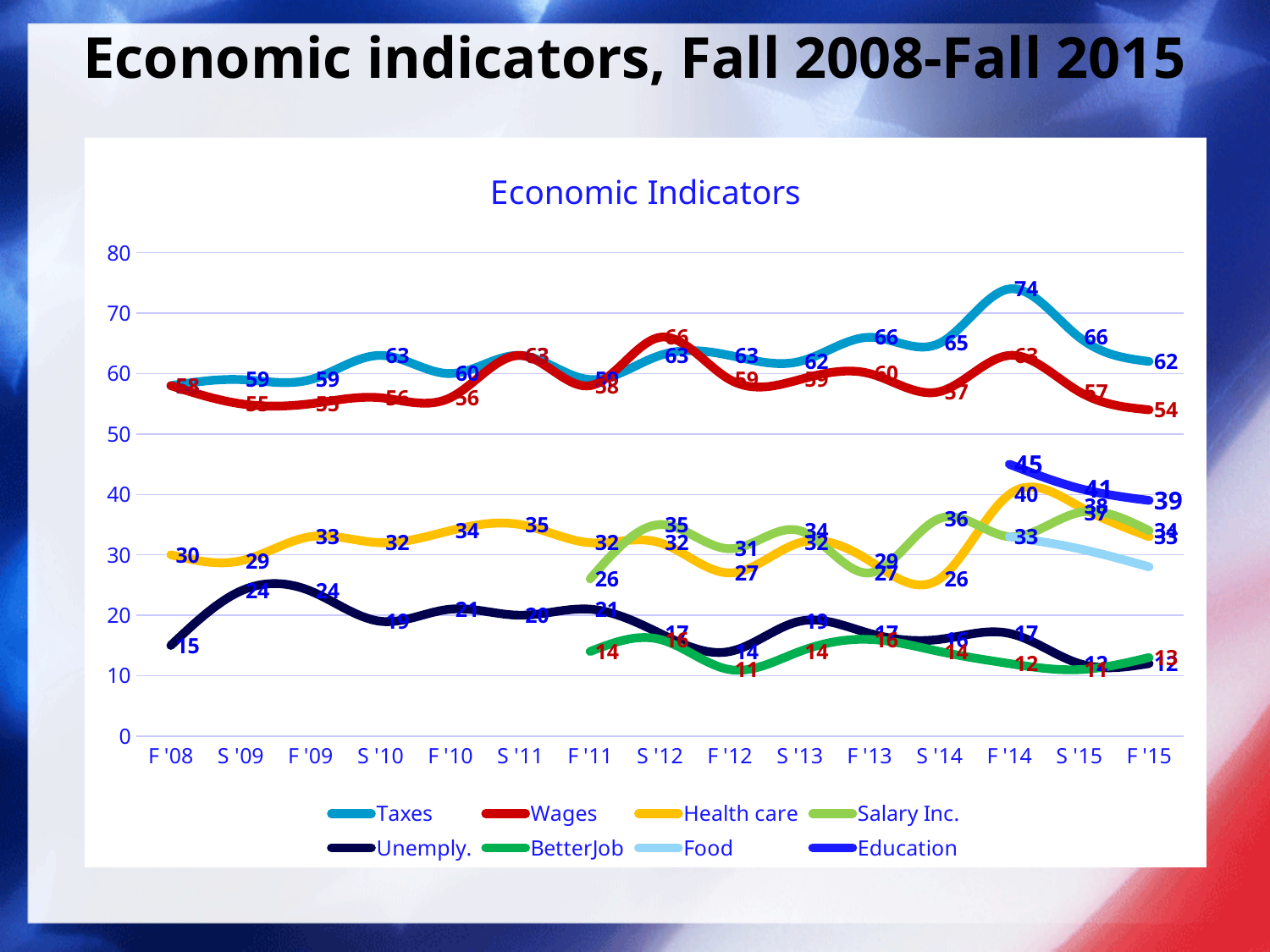
What kind of chart is shown on the slide? line chart Is the value for Unemply. at F '08 greater or less than 20? less What is the value for Education at F '14? 45 How many time points are shown along the x axis? 15 By how much does the Education value fall from F '14 to F '15? 6 At which time point does the Taxes series reach its highest value? F '14 At F '15, which is larger, Taxes or Wages? Taxes What is the title of the chart? Economic Indicators How many series does the legend list? 8 What is the value for Taxes at F '14? 74 What is the value for Health care at F '08? 30 What is the value for Wages at F '15? 54